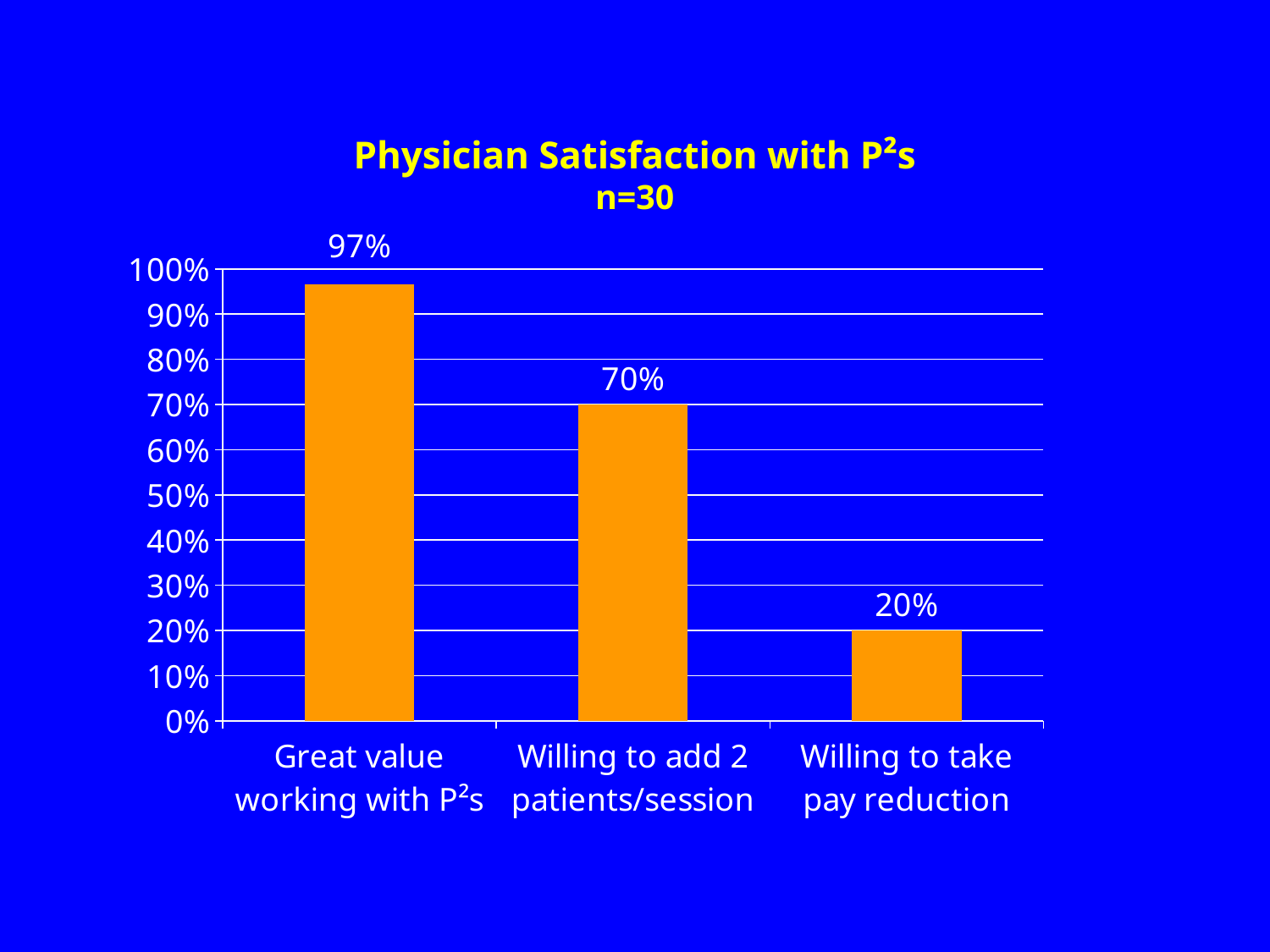
How many categories are shown in the chart? 3 Which category has the lowest value? Willing to take pay reduction Is the value for 'Willing to add 2 patients/session' greater or less than 50%? greater What is the value for 'Willing to add 2 patients/session'? 70% What sample size is stated in the chart title? n=30 What percentage of physicians said there is great value working with P²s? 97% What kind of chart is shown on the slide? Bar chart What is the difference between 'Willing to add 2 patients/session' and 'Willing to take pay reduction'? 50% Which category has the highest value? Great value working with P²s Which is larger: 'Willing to add 2 patients/session' or 'Willing to take pay reduction'? Willing to add 2 patients/session What is the difference between 'Great value working with P²s' and 'Willing to take pay reduction'? 77% What is the value for 'Willing to take pay reduction'? 20%